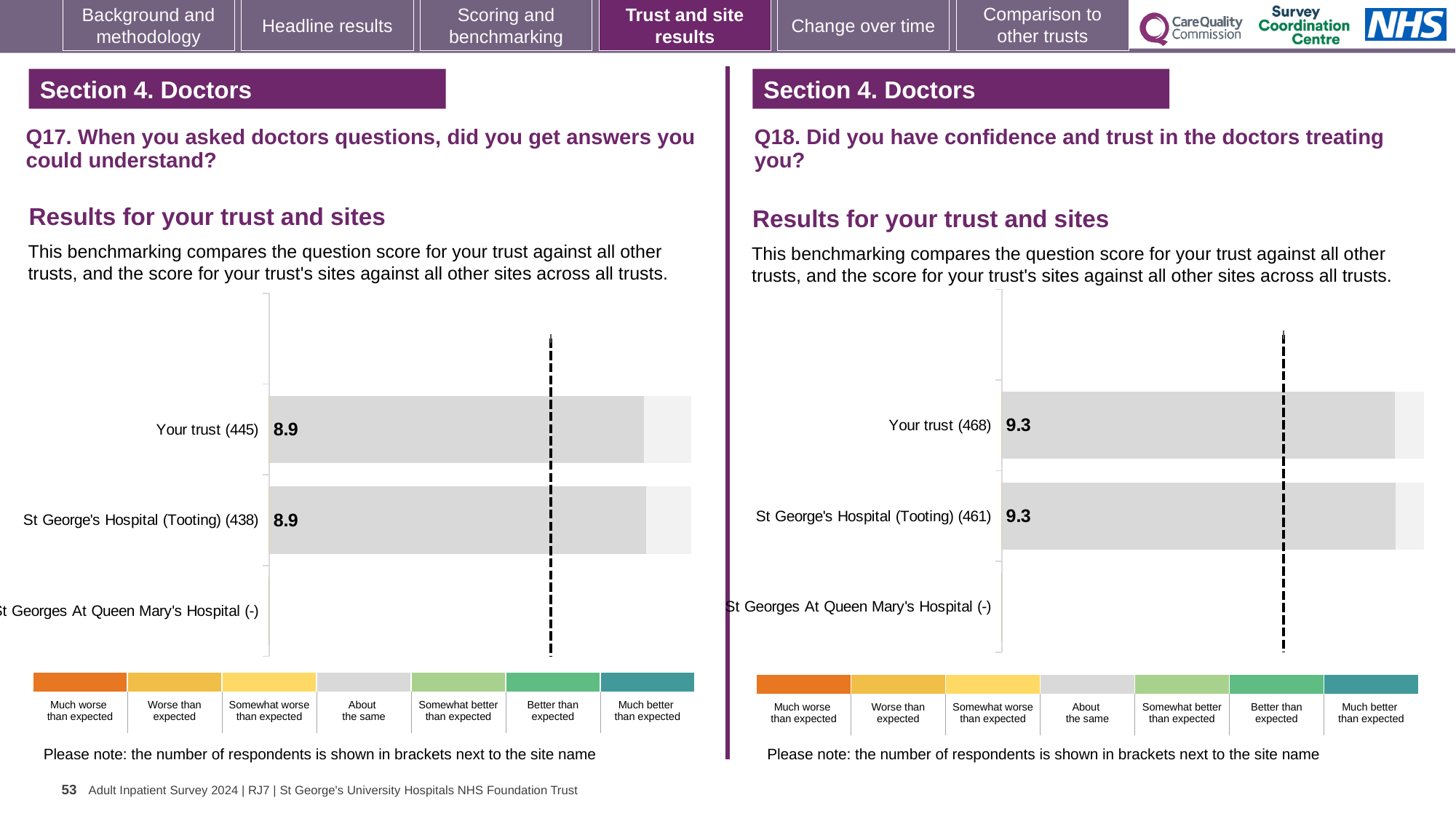
On the Q18 chart (right), what is the score for St George's Hospital (Tooting)? 9.3 On the Q17 chart (left), what is the difference between the score for Your trust and the score for St George's Hospital (Tooting)? 0 On the Q17 chart (left), how many respondents are shown in brackets for Your trust? 445 On the Q18 chart (right), what is the difference between the score for Your trust and the score for St George's Hospital (Tooting)? 0 On the Q18 chart (right), how many respondents are shown in brackets for St George's Hospital (Tooting)? 461 Is the score for Your trust on the Q18 chart (right) larger or smaller than the score for Your trust on the Q17 chart (left)? Larger On the Q18 chart (right), what is the score for Your trust? 9.3 On the Q17 chart (left), what is the score for St George's Hospital (Tooting)? 8.9 On the Q17 chart (left), what is the score for Your trust? 8.9 On the Q17 chart (left), how many categories are listed on the vertical axis? 3 What kind of chart is the Q17 chart (left)? Bar chart On the Q18 chart (right), how many categories are listed on the vertical axis? 3